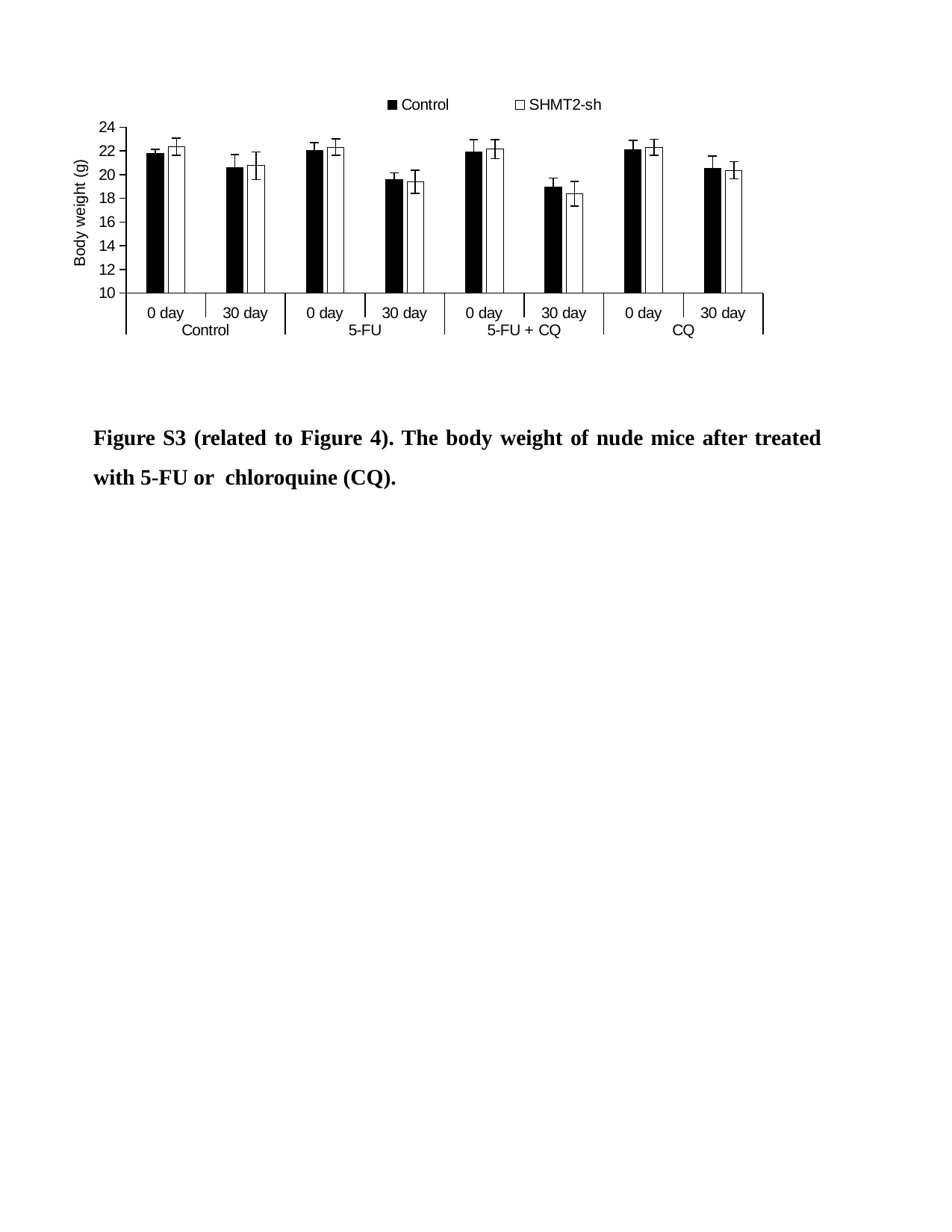
Is the Control value at 0 day in the Control group greater or less than 20? greater How many treatment groups are shown along the x axis? 4 Is the Control value at 30 day in the 5-FU group greater or less than 20? less In the 5-FU group, is the Control bar larger at 0 day or at 30 day? 0 day What are the two series named in the legend? Control and SHMT2-sh Which treatment group has the lowest body weight bars at 30 day? 5-FU + CQ Within each treatment group, do the body weight values rise or fall from 0 day to 30 day? fall What is the label of the vertical axis? Body weight (g) What kind of chart is shown on the slide? bar chart How many bars are plotted for the Control series in total? 8 Is the SHMT2-sh value at 30 day in the 5-FU + CQ group greater or less than 20? less How many series does the legend list? 2